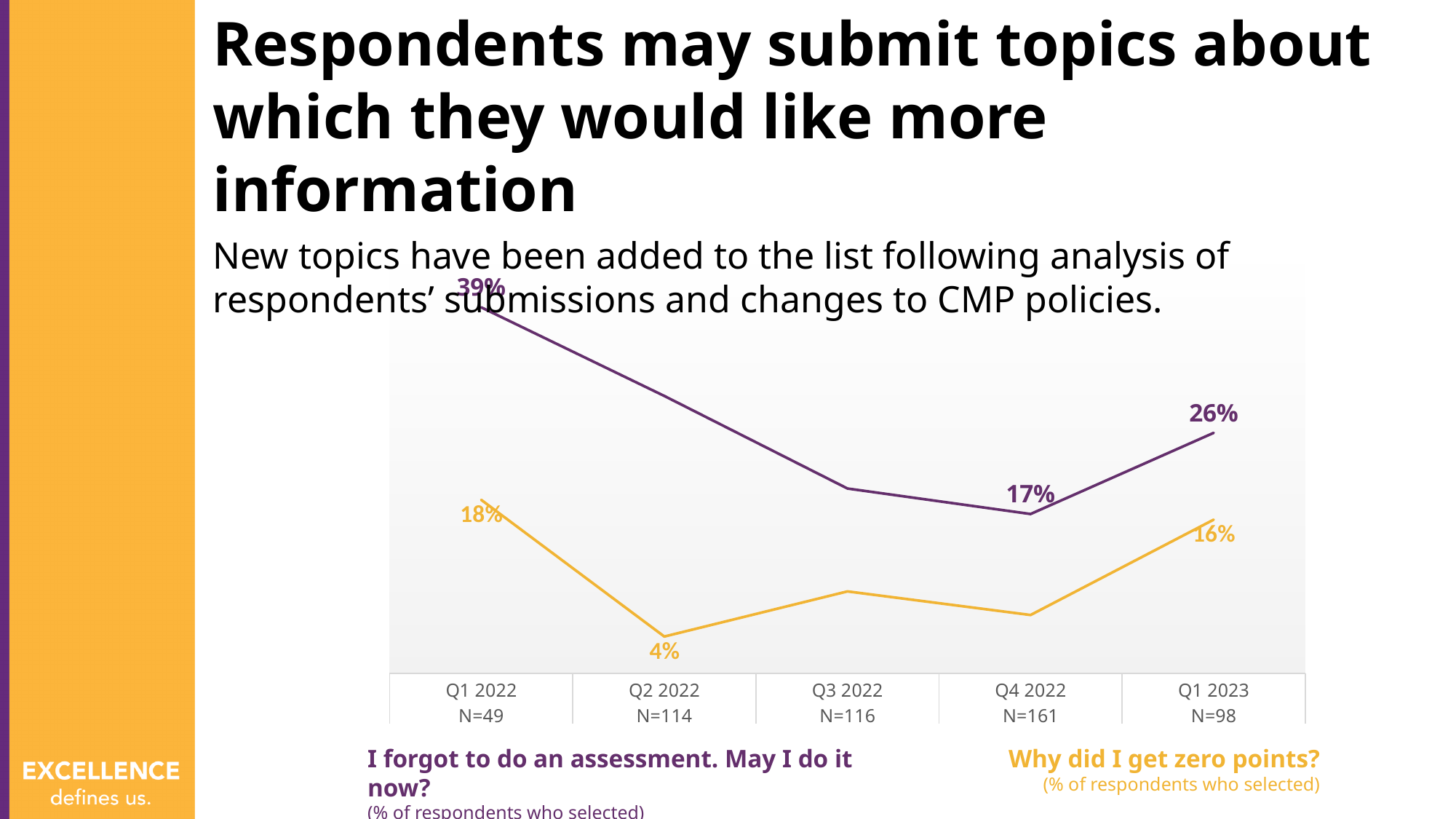
What is the value for "I forgot to do an assessment. May I do it now?" in Q1 2023? 26% By how many percentage points did "I forgot to do an assessment. May I do it now?" fall from Q1 2022 to Q1 2023? 13 percentage points How many quarters are shown on the x axis of the chart? 5 What is the value for "I forgot to do an assessment. May I do it now?" in Q4 2022? 17% What percentage of respondents selected "I forgot to do an assessment. May I do it now?" in Q1 2022? 39% What percentage of respondents selected "Why did I get zero points?" in Q2 2022? 4% What kind of chart is shown on the slide? Line chart What is the sample size (N) shown for Q4 2022? N=161 In which quarter is the "Why did I get zero points?" line at its lowest? Q2 2022 In which quarter is the "I forgot to do an assessment. May I do it now?" line at its highest? Q1 2022 What is the value for "Why did I get zero points?" in Q1 2023? 16% In Q1 2023, which topic was selected by a larger share of respondents? I forgot to do an assessment. May I do it now?